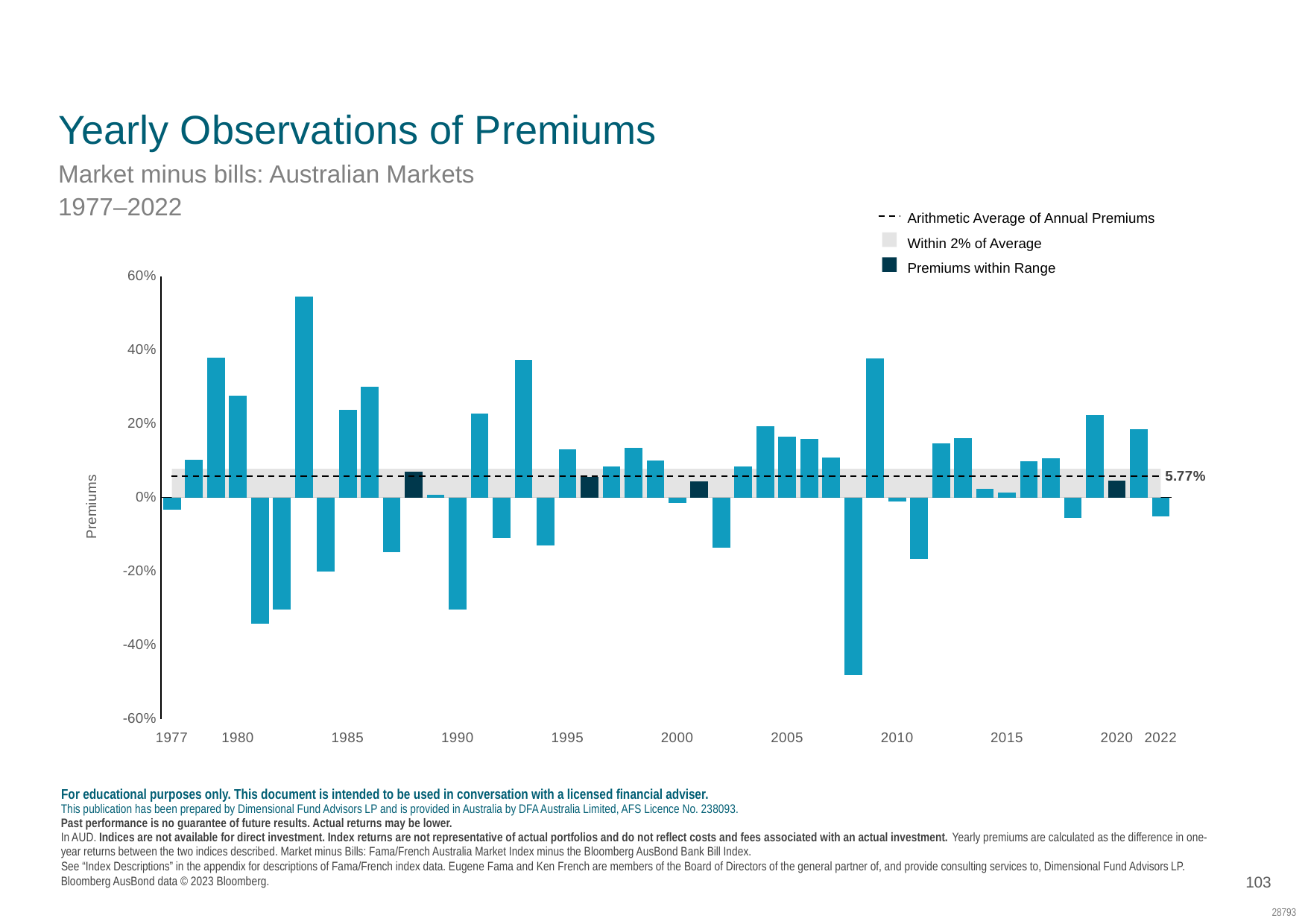
Is the premium for 1983 greater or less than 40%? greater Which year has the lowest premium on the chart? 2008 Is the premium for 2009 greater or less than 20%? greater Which year has the larger premium, 1983 or 2009? 1983 How many years does the chart cover, from 1977 to 2022? 46 Is the premium for 2020 greater or less than 20%? less What is the arithmetic average of annual premiums shown by the dashed line? 5.77% What kind of chart is shown on the slide? bar chart Which year has the highest premium on the chart? 1983 How many entries does the legend list? 3 What is the title of the chart? Yearly Observations of Premiums